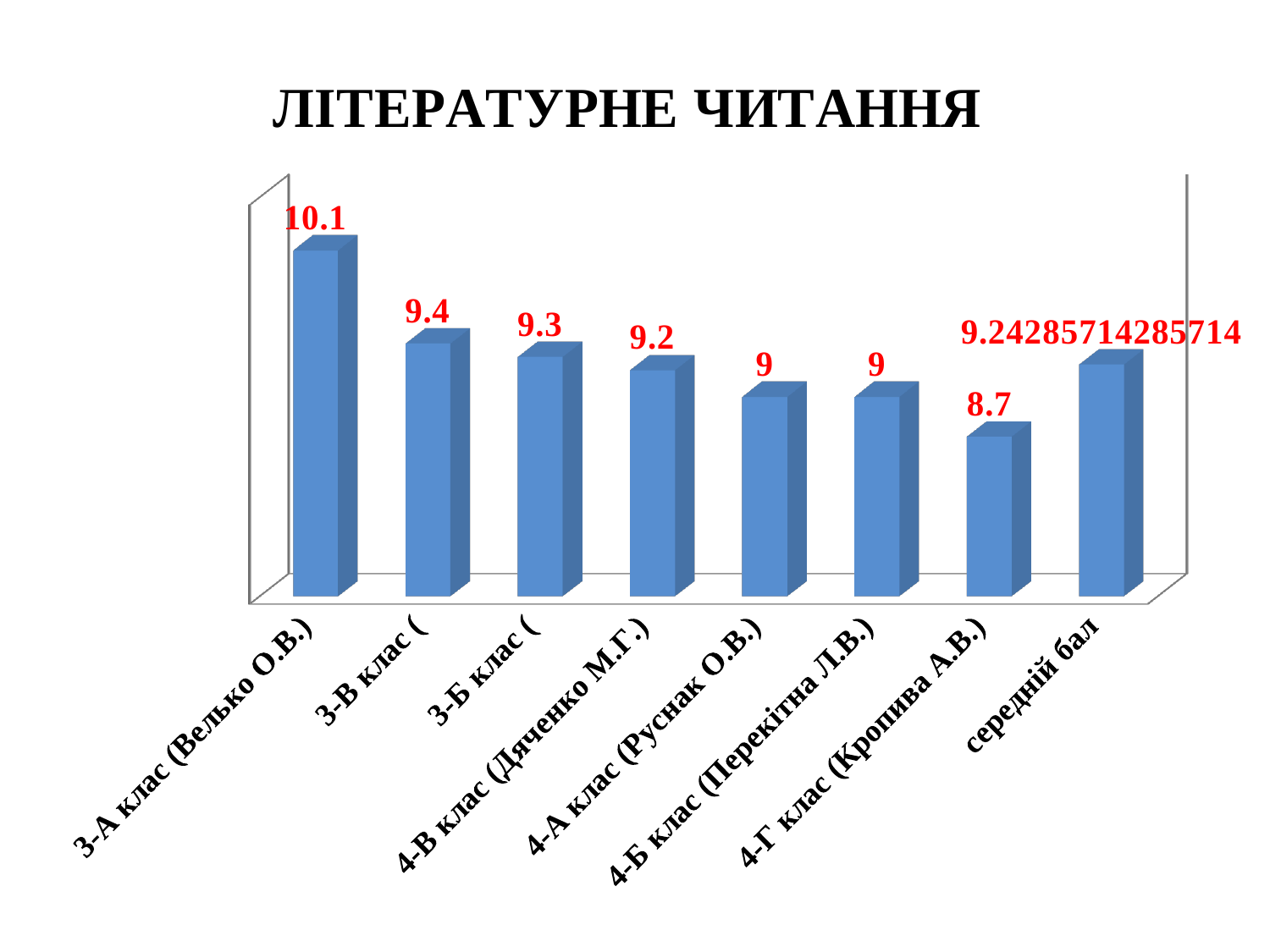
Which is larger, the value for 3-Б клас or the value for 4-В клас (Дяченко М.Г.)? 3-Б клас What type of chart is shown on the slide? Bar chart What is the value for 3-А клас (Велько О.В.)? 10.1 What is the value for 4-В клас (Дяченко М.Г.)? 9.2 What is the difference between the values for 3-В клас and 3-Б клас? 0.1 What is the value for 4-Г клас (Кропива А.В.)? 8.7 Which category has the lowest value? 4-Г клас (Кропива А.В.) What is the difference between the values for 3-А клас (Велько О.В.) and 4-Г клас (Кропива А.В.)? 1.4 What is the value shown for середній бал? 9.24285714285714 How many bars are shown in the chart? 8 What is the value for 4-А клас (Руснак О.В.)? 9 Which category has the highest value? 3-А клас (Велько О.В.)